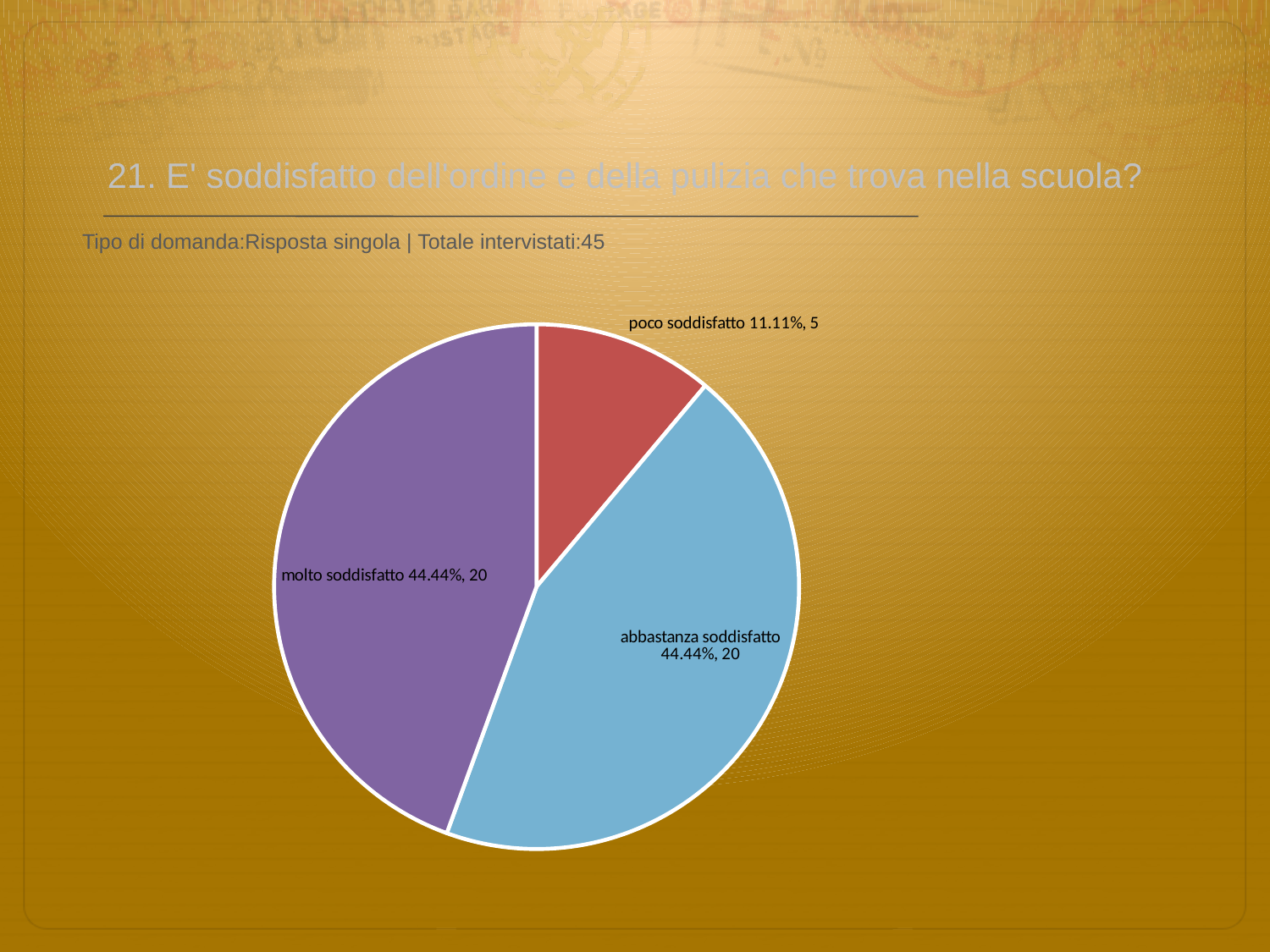
What percentage of respondents answered "molto soddisfatto"? 44.44% What is the total number of respondents across all slices of the pie? 45 What percentage of respondents answered "poco soddisfatto"? 11.11% How many respondents answered "abbastanza soddisfatto"? 20 Which has more respondents, "abbastanza soddisfatto" or "poco soddisfatto"? abbastanza soddisfatto What is the difference in number of respondents between "molto soddisfatto" and "poco soddisfatto"? 15 What colour is the "poco soddisfatto" slice? red How many slices does the pie chart have? 3 How many respondents answered "molto soddisfatto"? 20 What kind of chart is shown on the slide? pie chart Which response category has the smallest slice of the pie? poco soddisfatto How many respondents answered "poco soddisfatto"? 5